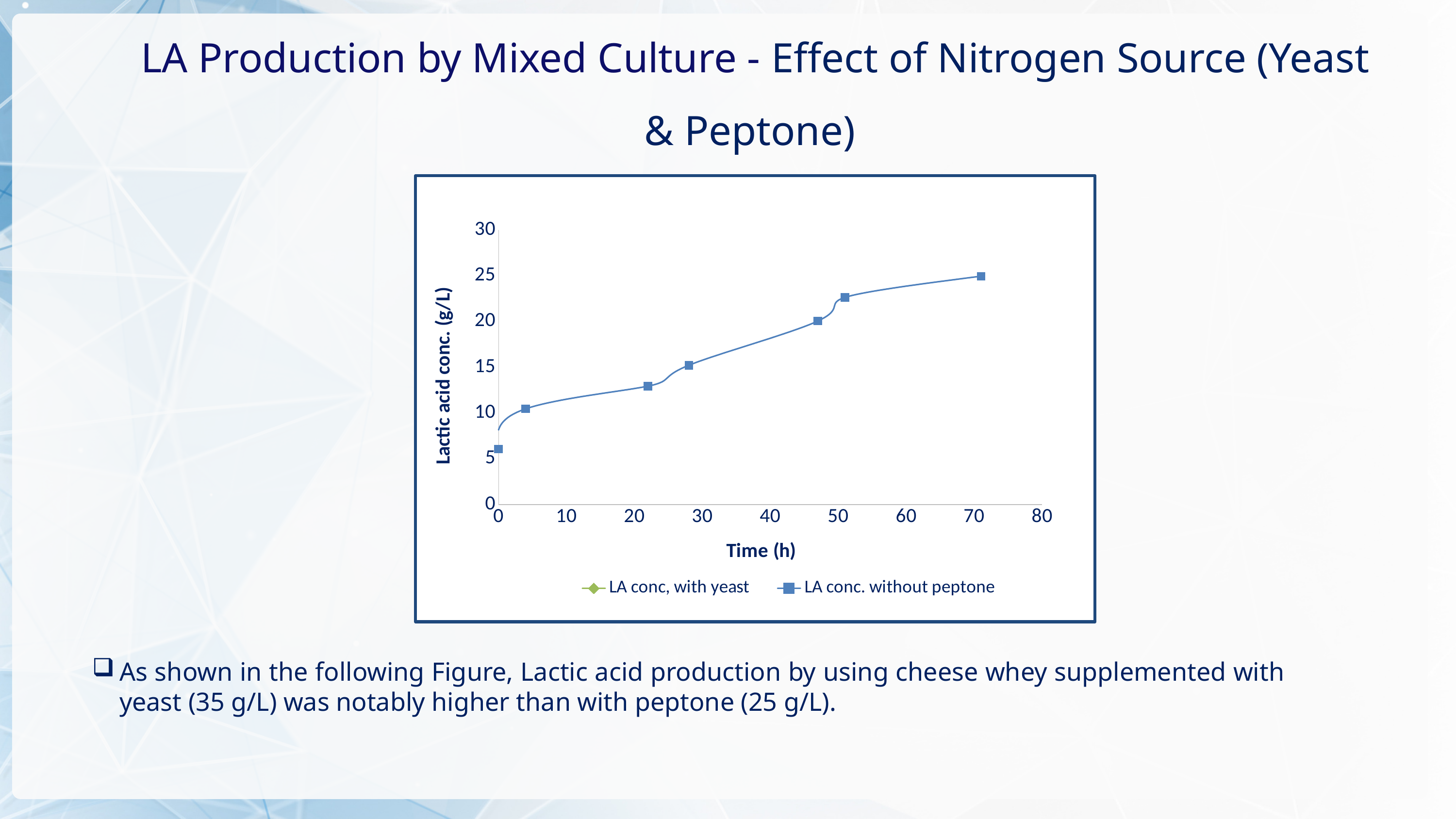
Is the value of the LA conc. without peptone series at about 70 h larger or smaller than the value at about 4 h? larger Which plotted point of the LA conc. without peptone series has the lowest value: the first point or the last point? the first point Is the value of the LA conc. without peptone series at time 0 h greater or less than 10? less What is the title of the y axis of the chart? Lactic acid conc. (g/L) How many data points are plotted for the LA conc. without peptone series? 7 Does the plotted LA conc. without peptone series rise or fall as time increases? rise Is the last plotted value of the LA conc. without peptone series (at about 70 h) greater or less than 20? greater What is the title of the x axis of the chart? Time (h) Is the value of the LA conc. without peptone series at about 22 h greater or less than 10? greater What kind of chart is shown on the slide? line chart How many series does the chart legend list? 2